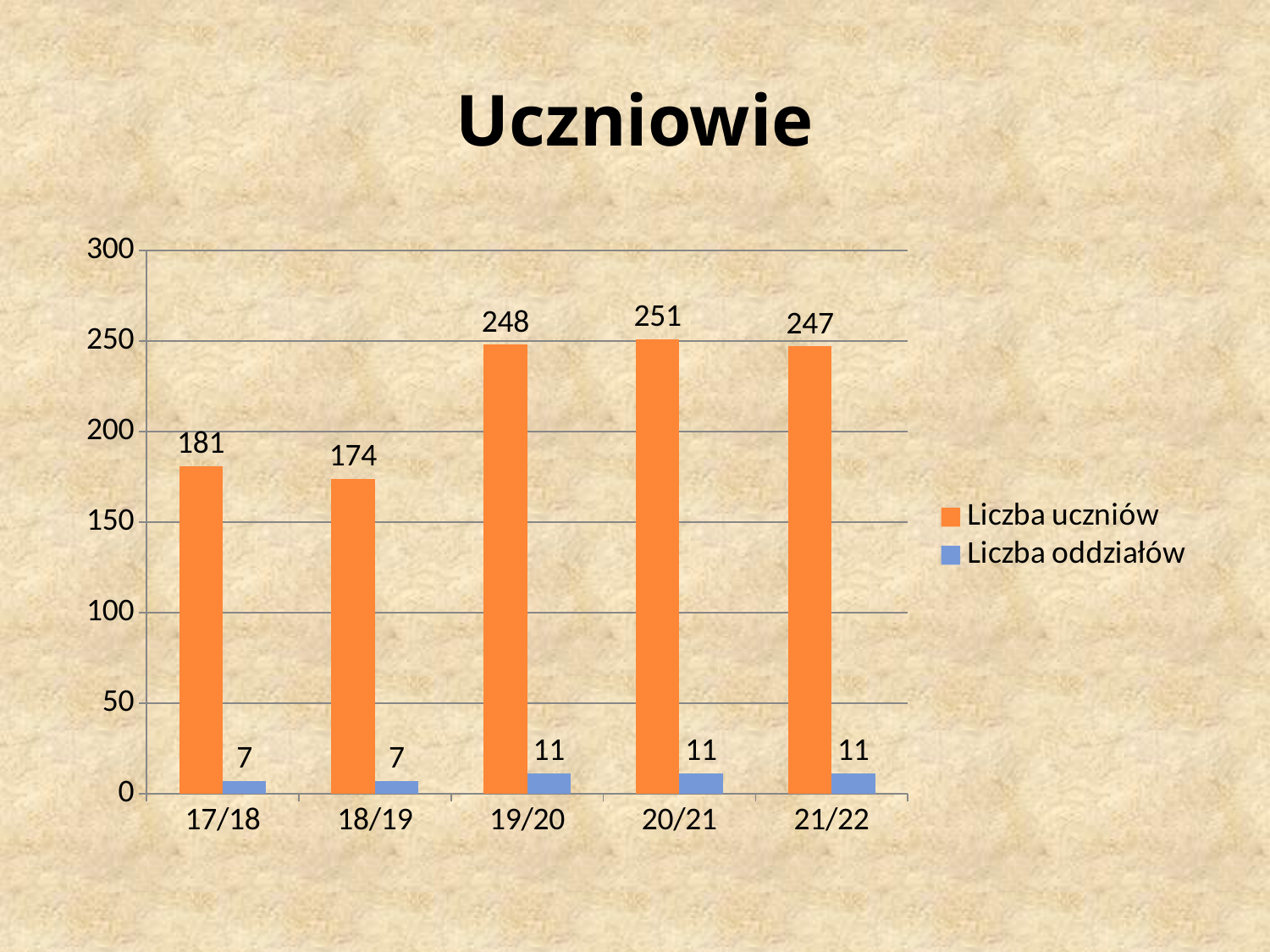
What is the value of Liczba oddziałów for 19/20? 11 What is the value of Liczba uczniów for 21/22? 247 What is the value of Liczba uczniów for 17/18? 181 How many years are shown on the x axis? 5 What is the difference between Liczba uczniów in 19/20 and 18/19? 74 Which year has the highest value for Liczba uczniów? 20/21 Is the value of Liczba uczniów for 20/21 greater or less than 250? greater Which is larger, Liczba uczniów in 17/18 or in 18/19? 17/18 What kind of chart is shown on the slide? bar chart What is the title of the chart? Uczniowie Which year has the lowest value for Liczba uczniów? 18/19 How many series does the legend list? 2